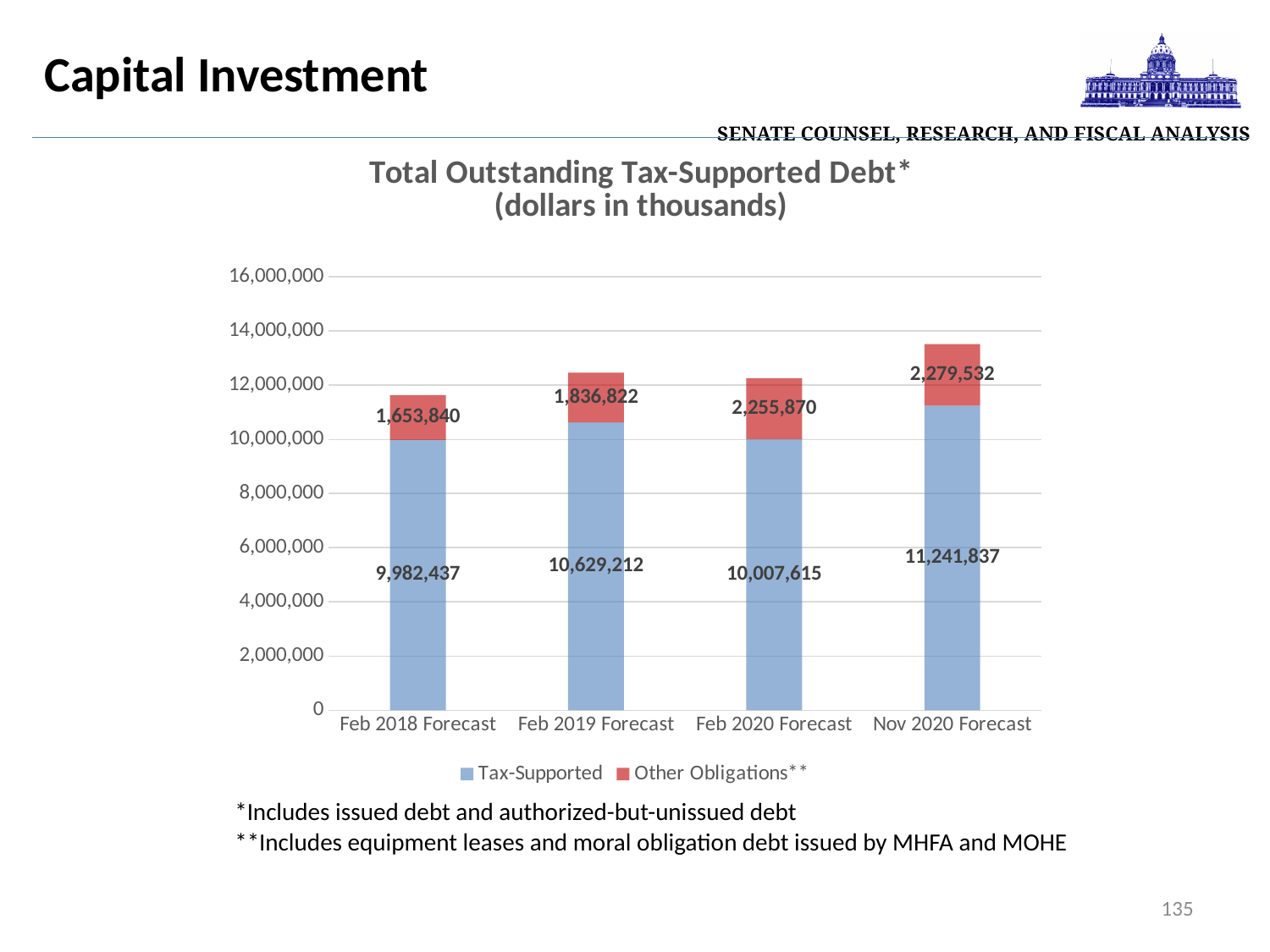
How many forecast categories are shown on the x axis? 4 Which is larger, the Tax-Supported value for the Feb 2019 Forecast or for the Feb 2020 Forecast? Feb 2019 Forecast What is the Other Obligations** value for the Feb 2020 Forecast? 2,255,870 How many series does the legend list? 2 What is the Tax-Supported value for the Feb 2019 Forecast? 10,629,212 What is the Tax-Supported value for the Nov 2020 Forecast? 11,241,837 Which forecast has the lowest Other Obligations** value? Feb 2018 Forecast What kind of chart is shown on the slide? Stacked bar chart Is the total height of the Feb 2018 Forecast bar greater or less than 12,000,000? less What is the total of the stacked bar for the Nov 2020 Forecast? 13,521,369 What is the difference between the Tax-Supported values for the Nov 2020 Forecast and the Feb 2018 Forecast? 1,259,400 Which forecast has the highest Tax-Supported value? Nov 2020 Forecast